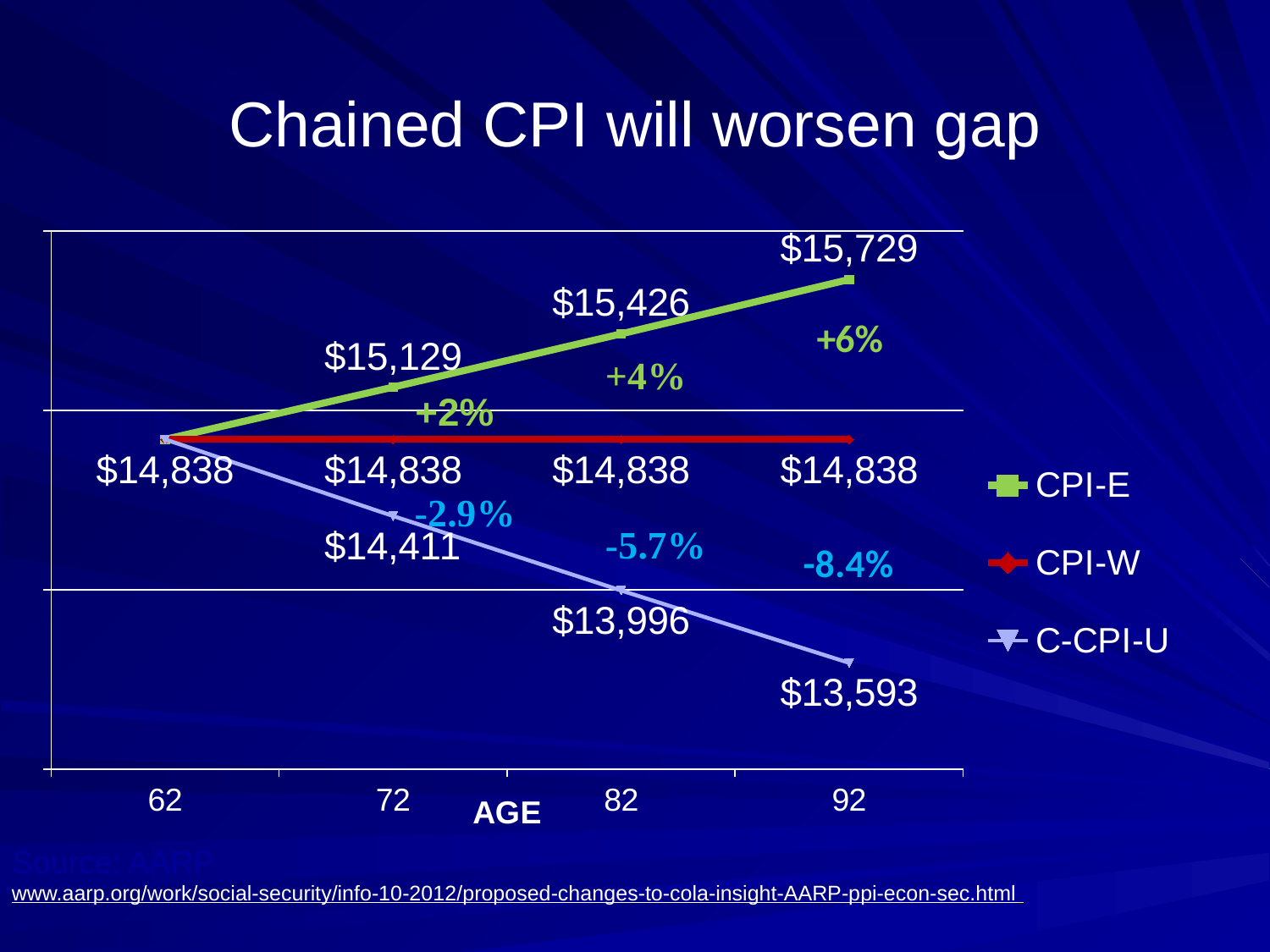
What is the difference between the CPI-E and C-CPI-U values at age 92? $2,136 What is the value of the C-CPI-U series at age 72? $14,411 At age 72, which is larger: the CPI-E value or the C-CPI-U value? CPI-E What is the value of the CPI-E series at age 92? $15,729 Which series has the lowest value at age 82? C-CPI-U What is the value of the CPI-W series at age 72? $14,838 Which series has the highest value at age 92? CPI-E What is the value of the C-CPI-U series at age 82? $13,996 What kind of chart is shown on the slide? Line chart How many age points are plotted on the x axis? 4 Does the C-CPI-U series rise or fall as age increases from 62 to 92? Fall How many series does the legend list? 3